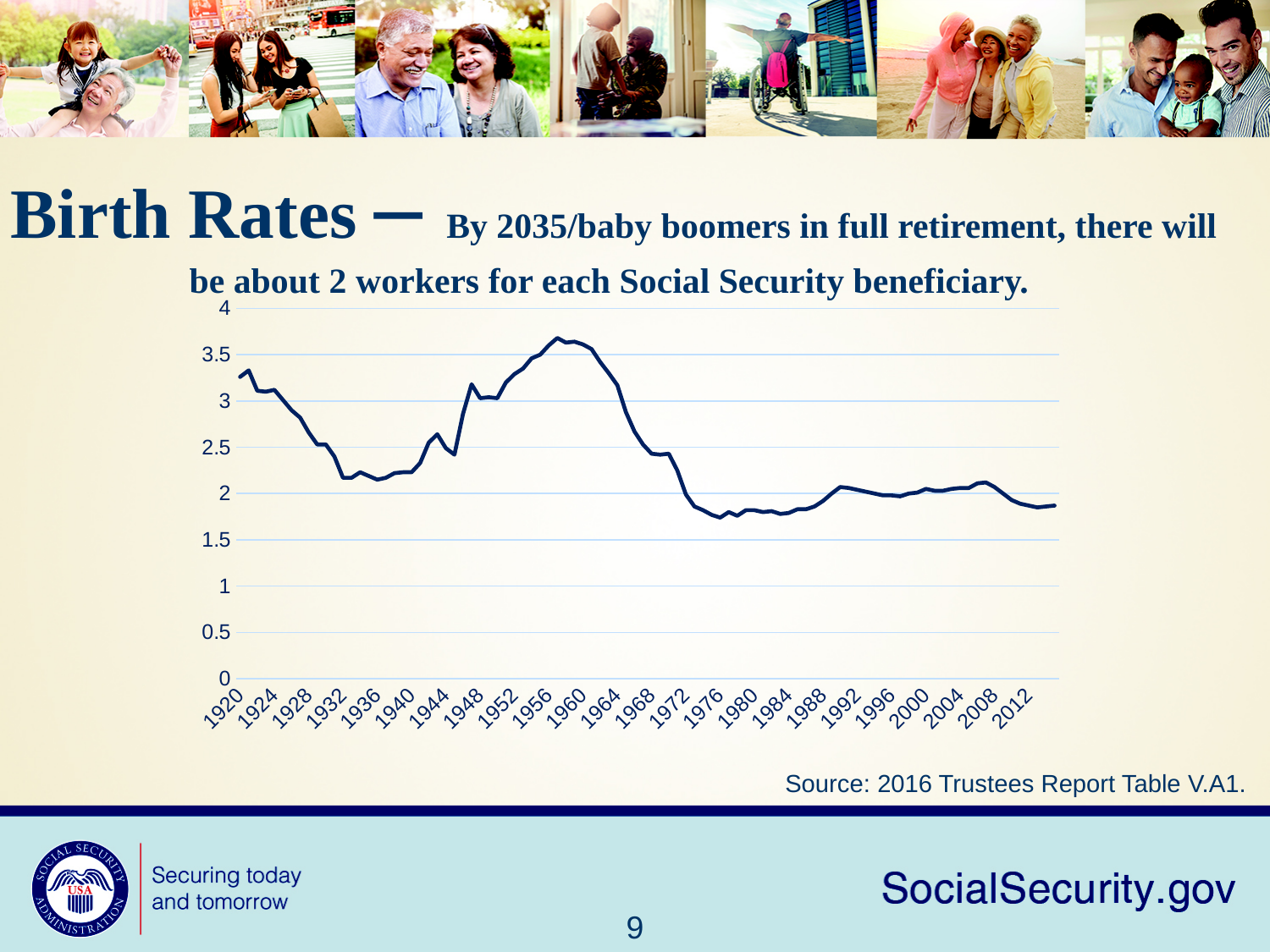
In which decade does the line reach its highest point? 1950s Is the birth rate value for 1976 greater or less than 2? less Is the birth rate value for 1960 greater or less than 3.5? greater What source is cited below the chart? 2016 Trustees Report Table V.A1. Is the birth rate value for 1936 greater or less than 2.5? less How many year labels are shown on the x axis? 24 Which year has the larger birth rate, 1920 or 2012? 1920 Does the birth rate rise or fall between 1960 and 1976? fall What kind of chart is shown on the slide? line chart Which year has the larger birth rate, 1960 or 1980? 1960